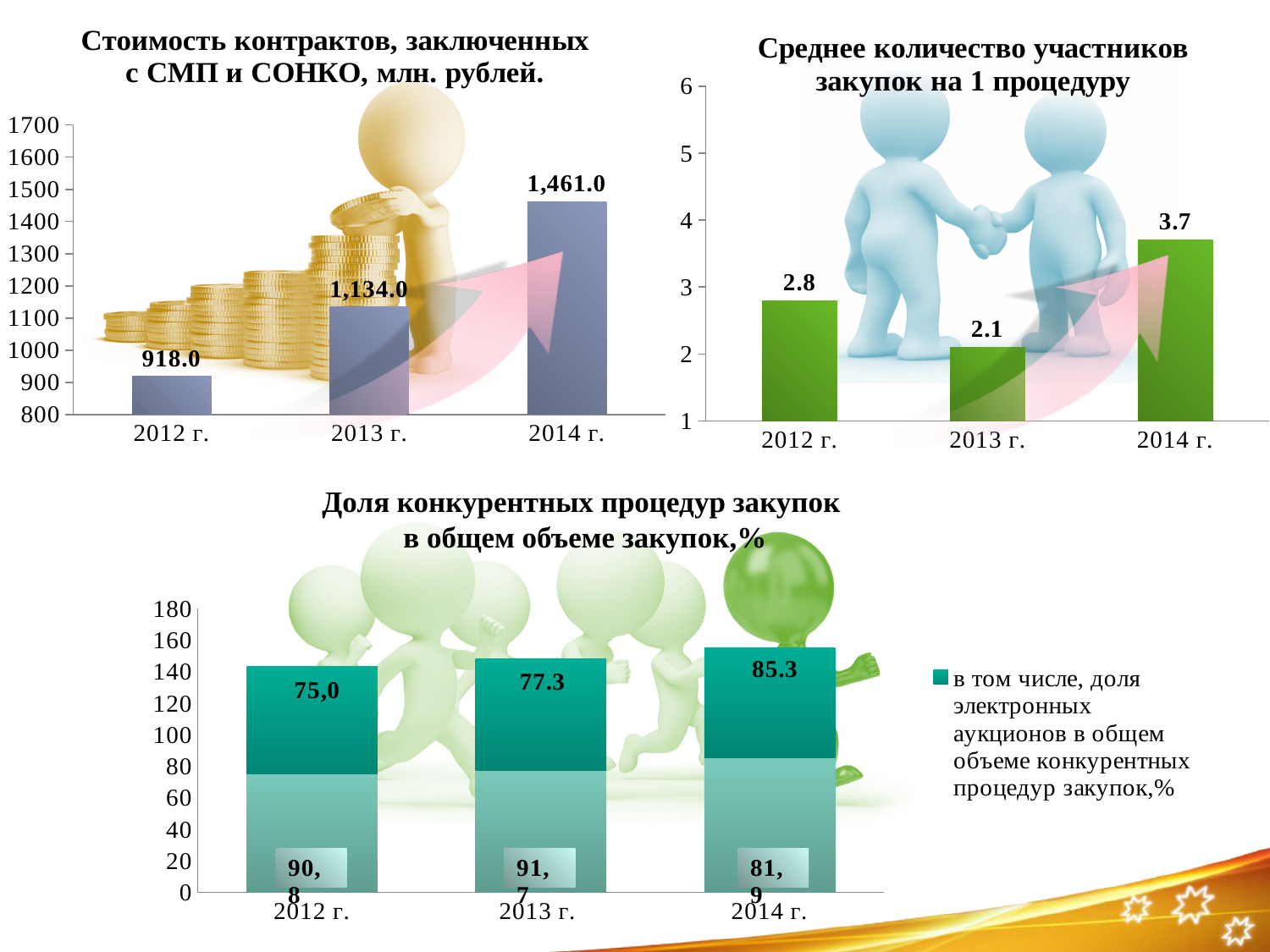
In the chart 'Стоимость контрактов, заключенных с СМП и СОНКО, млн. рублей.', do the values rise or fall from 2012 г. to 2014 г.? rise In the chart 'Стоимость контрактов, заключенных с СМП и СОНКО, млн. рублей.', what is the value for 2012 г.? 918.0 In the chart 'Среднее количество участников закупок на 1 процедуру', what is the difference between the 2014 г. and 2013 г. values? 1.6 In the chart 'Среднее количество участников закупок на 1 процедуру', which year has the lowest value? 2013 г. In the chart 'Среднее количество участников закупок на 1 процедуру', what is the value for 2013 г.? 2.1 In the chart 'Среднее количество участников закупок на 1 процедуру', which is larger, the value for 2012 г. or for 2014 г.? 2014 г. In the chart 'Стоимость контрактов, заключенных с СМП и СОНКО, млн. рублей.', what is the difference between the 2014 г. and 2012 г. values? 543.0 In the chart 'Стоимость контрактов, заключенных с СМП и СОНКО, млн. рублей.', which year has the highest value? 2014 г. What kind of chart is 'Стоимость контрактов, заключенных с СМП и СОНКО, млн. рублей.'? bar chart In the chart 'Доля конкурентных процедур закупок в общем объеме закупок,%', what is the value of the upper (dark teal) segment for 2014 г.? 85.3 In the chart 'Стоимость контрактов, заключенных с СМП и СОНКО, млн. рублей.', what is the value for 2014 г.? 1,461.0 How many years are shown on the x axis of the chart 'Среднее количество участников закупок на 1 процедуру'? 3